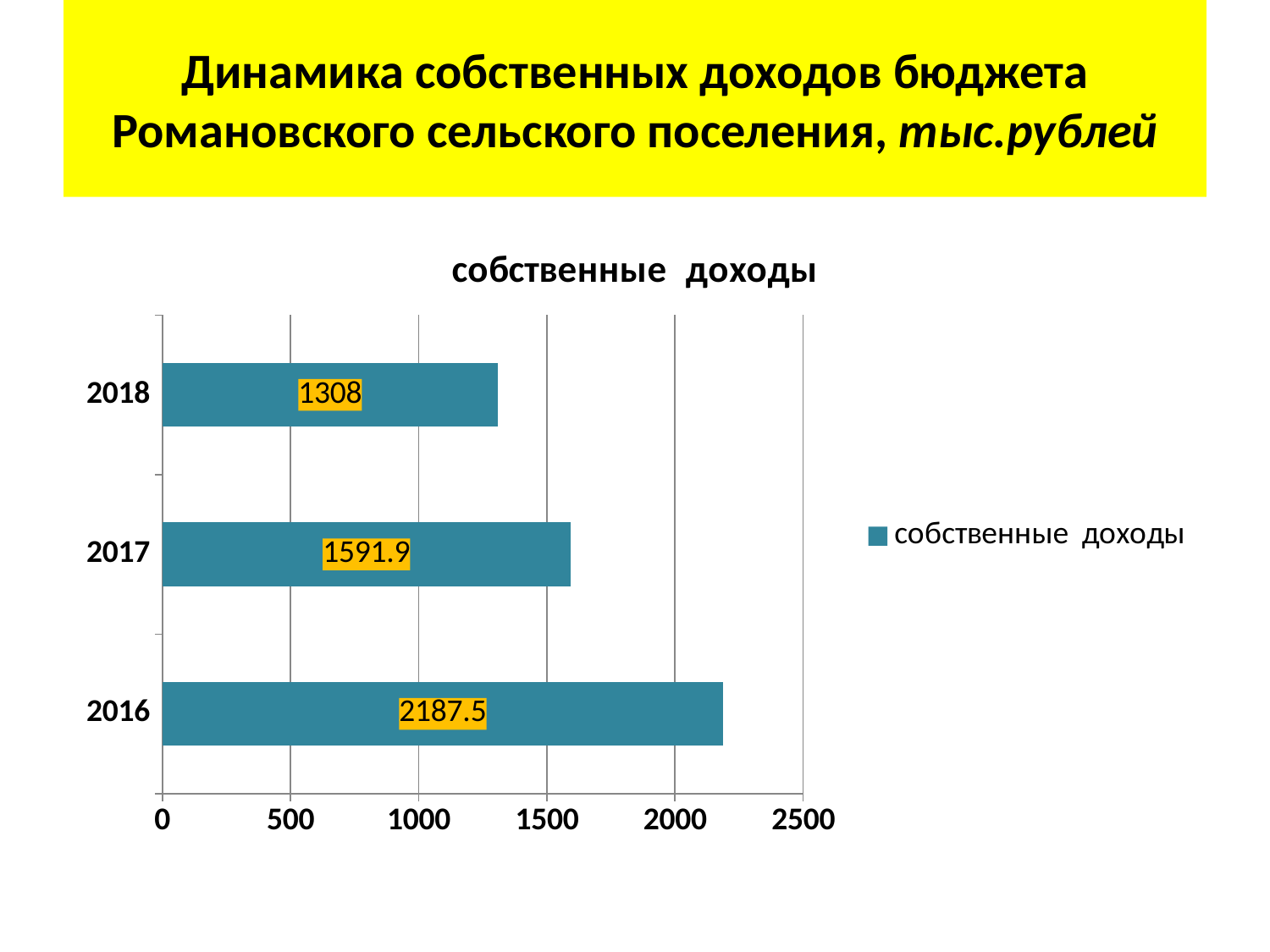
What kind of chart is shown? bar chart Is the value for 2017 greater or less than 1500? greater What is the title of the chart? собственные доходы What is the difference between the values for 2017 and 2018? 283.9 What is the value for 2016? 2187.5 Which year has the highest value? 2016 What is the value for 2017? 1591.9 Which year has the lowest value? 2018 Which is larger, the value for 2017 or the value for 2016? 2016 What is the value for 2018? 1308 How many years are shown in the chart? 3 What is the difference between the values for 2016 and 2018? 879.5